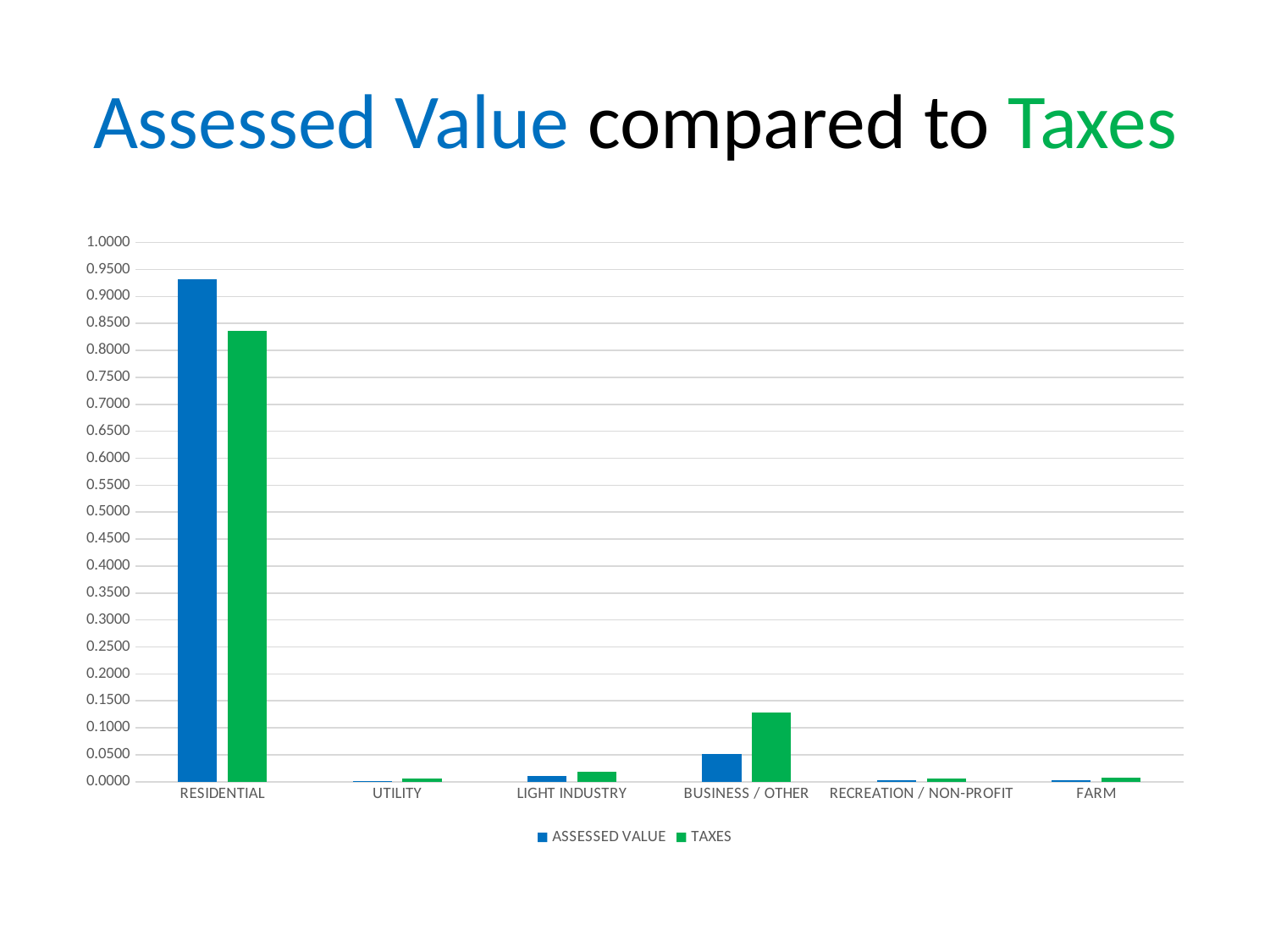
Is the TAXES value for BUSINESS / OTHER greater or less than 0.1000? greater How many series does the legend list? 2 What kind of chart is shown on the slide? bar chart For RESIDENTIAL, which is larger: ASSESSED VALUE or TAXES? ASSESSED VALUE For BUSINESS / OTHER, which is larger: ASSESSED VALUE or TAXES? TAXES Is the ASSESSED VALUE for RESIDENTIAL greater or less than 0.9000? greater What colour represents the TAXES series in the chart? green Which category has the highest ASSESSED VALUE? RESIDENTIAL Which category has the highest TAXES value? RESIDENTIAL Is the ASSESSED VALUE for BUSINESS / OTHER greater or less than 0.1000? less How many categories are shown along the x axis? 6